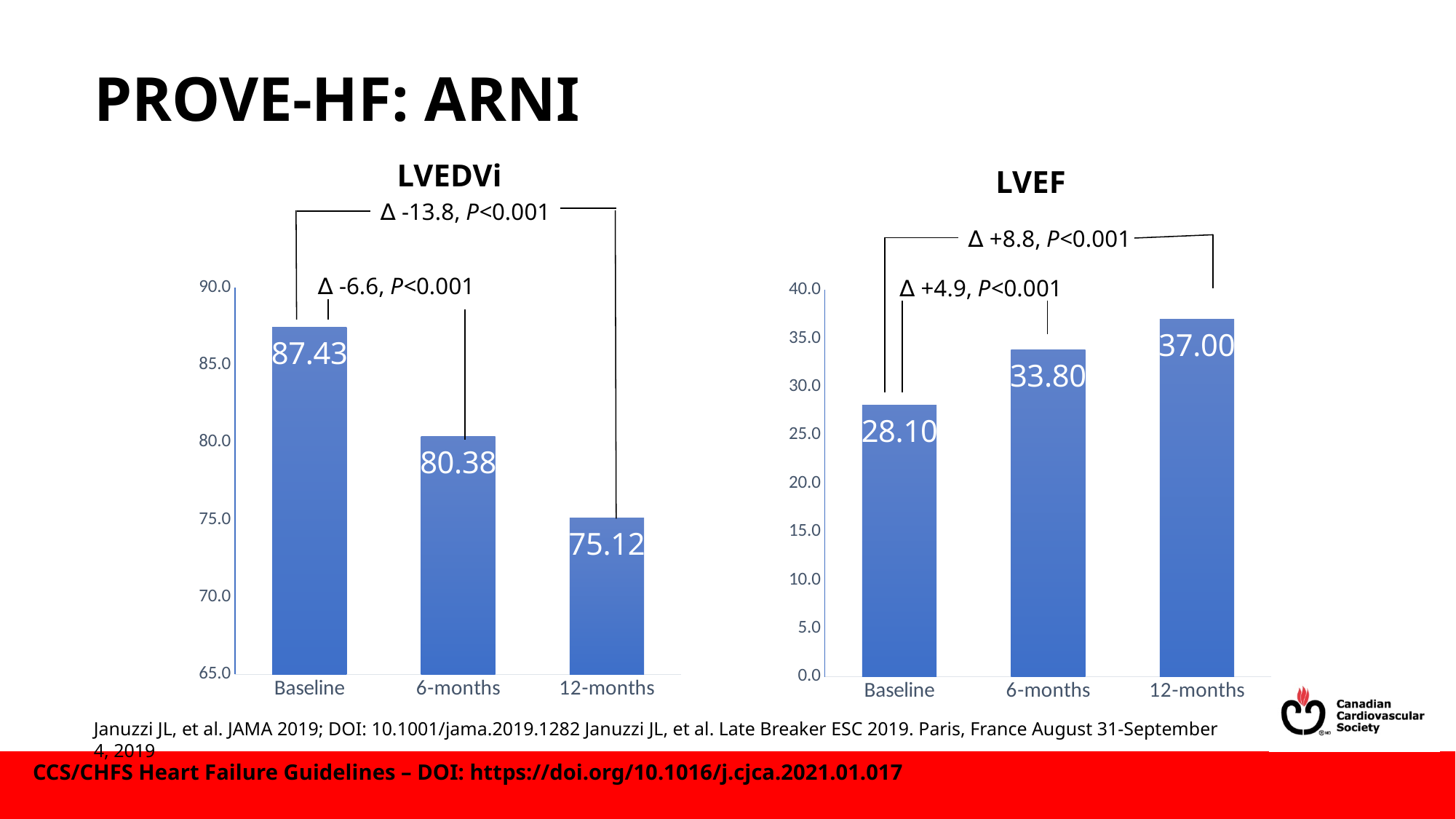
In the LVEDVi chart, which time point has the lowest value? 12-months How many time points are shown in the LVEF chart? 3 In the LVEDVi chart, what is the value at 12-months? 75.12 What kind of chart is the LVEDVi chart? bar chart In the LVEF chart, is the value at Baseline greater or less than 30.0? less In the LVEF chart, what is the value at 6-months? 33.80 In the LVEF chart, what is the value at 12-months? 37.00 In the LVEDVi chart, what is the difference between the Baseline value and the 6-months value? 7.05 In the LVEF chart, which time point has the highest value? 12-months In the LVEDVi chart, do the values rise or fall from Baseline to 12-months? fall In the LVEDVi chart, what is the value at Baseline? 87.43 In the LVEF chart, what is the difference between the 12-months value and the Baseline value? 8.90